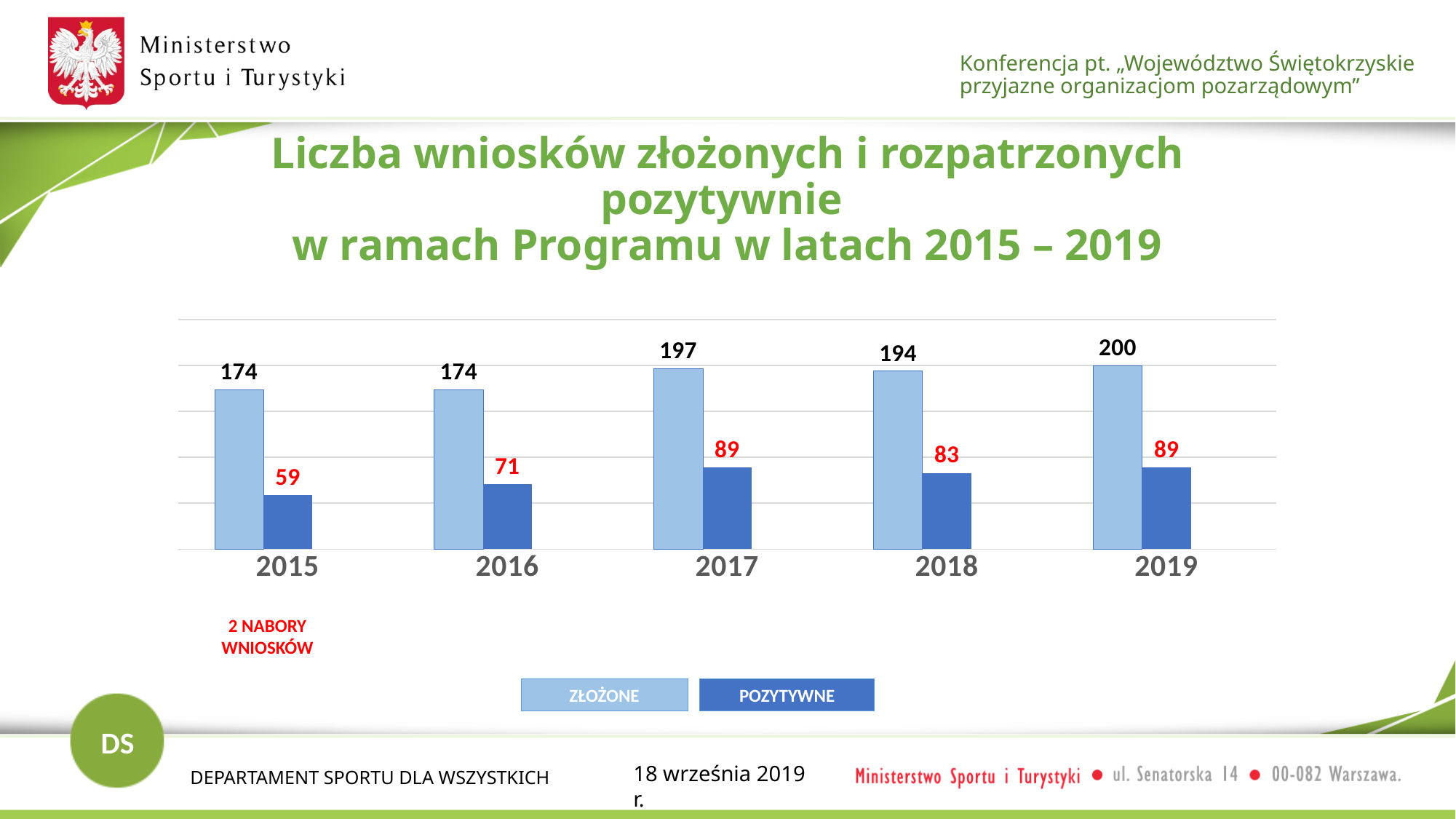
What is the value of POZYTYWNE for 2018? 83 How many years are shown on the x axis? 5 Which year has the highest ZŁOŻONE value? 2019 Which series is shown in the darker blue colour? POZYTYWNE What kind of chart is shown on the slide? bar chart Which is larger, the POZYTYWNE value for 2017 or for 2018? 2017 How many series does the legend list? 2 Which year has the lowest POZYTYWNE value? 2015 What is the difference between ZŁOŻONE and POZYTYWNE in 2019? 111 What is the value of ZŁOŻONE for 2017? 197 What is the value of POZYTYWNE for 2015? 59 What is the difference between the POZYTYWNE values for 2016 and 2015? 12